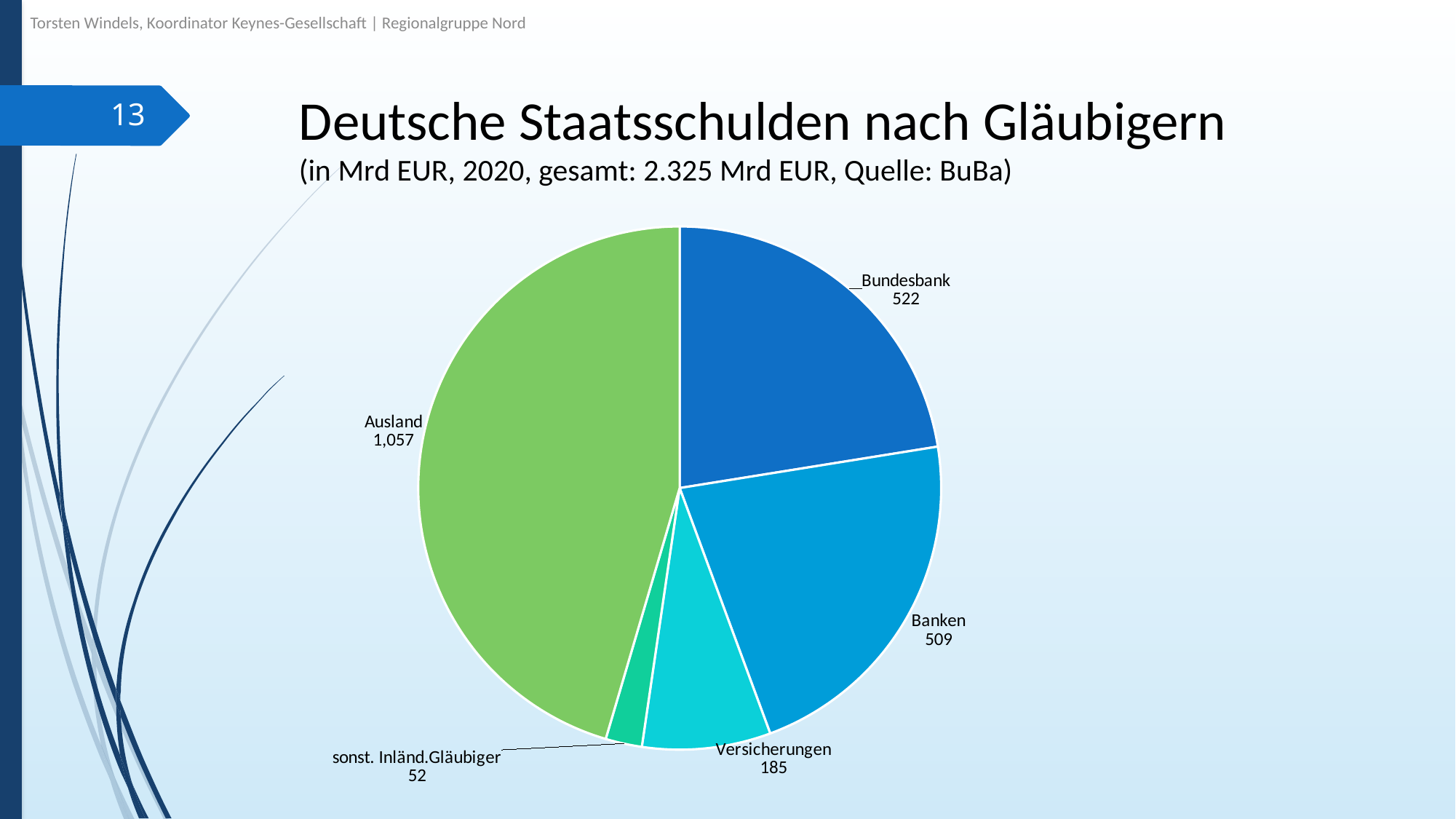
How many categories are shown in the pie chart? 5 Which category has the largest slice of the pie chart? Ausland What is the value for Bundesbank in the pie chart? 522 What is the difference between the values for Banken and Versicherungen? 324 What is the value for Ausland in the pie chart? 1,057 What is the difference between the values for Ausland and Bundesbank? 535 Which category has the smallest slice of the pie chart? sonst. Inländ.Gläubiger Which is larger, the value for Bundesbank or the value for Banken? Bundesbank What kind of chart is shown on the slide? pie chart What is the title of the chart on the slide? Deutsche Staatsschulden nach Gläubigern What is the value for Versicherungen in the pie chart? 185 What is the value for sonst. Inländ.Gläubiger in the pie chart? 52